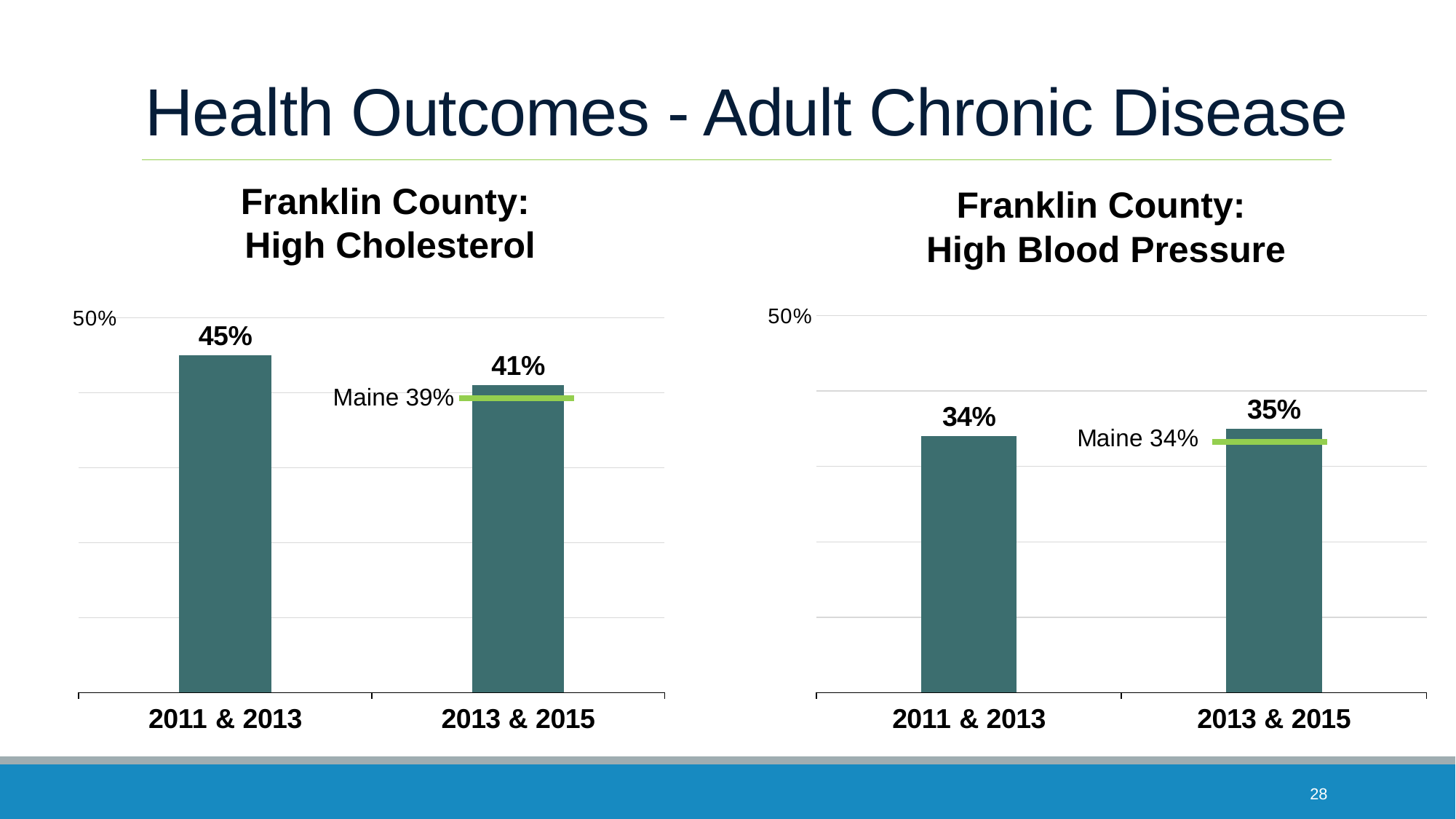
In the Franklin County: High Blood Pressure chart, which period has the lower value? 2011 & 2013 In the Franklin County: High Cholesterol chart, what is the difference between the 2011 & 2013 value and the 2013 & 2015 value? 4% In the Franklin County: High Blood Pressure chart, what is the value for 2013 & 2015? 35% In the Franklin County: High Cholesterol chart, what is the Maine value shown by the green line? 39% In the Franklin County: High Cholesterol chart, what is the value for 2013 & 2015? 41% In the Franklin County: High Cholesterol chart, do the values rise or fall from 2011 & 2013 to 2013 & 2015? fall In the Franklin County: High Cholesterol chart, what is the value for 2011 & 2013? 45% What kind of chart is the Franklin County: High Blood Pressure chart? bar chart In the Franklin County: High Blood Pressure chart, what is the value for 2011 & 2013? 34% In the Franklin County: High Blood Pressure chart, how many bars are plotted? 2 In the Franklin County: High Blood Pressure chart, what is the Maine value shown by the green line? 34% In the Franklin County: High Cholesterol chart, which period has the higher value? 2011 & 2013